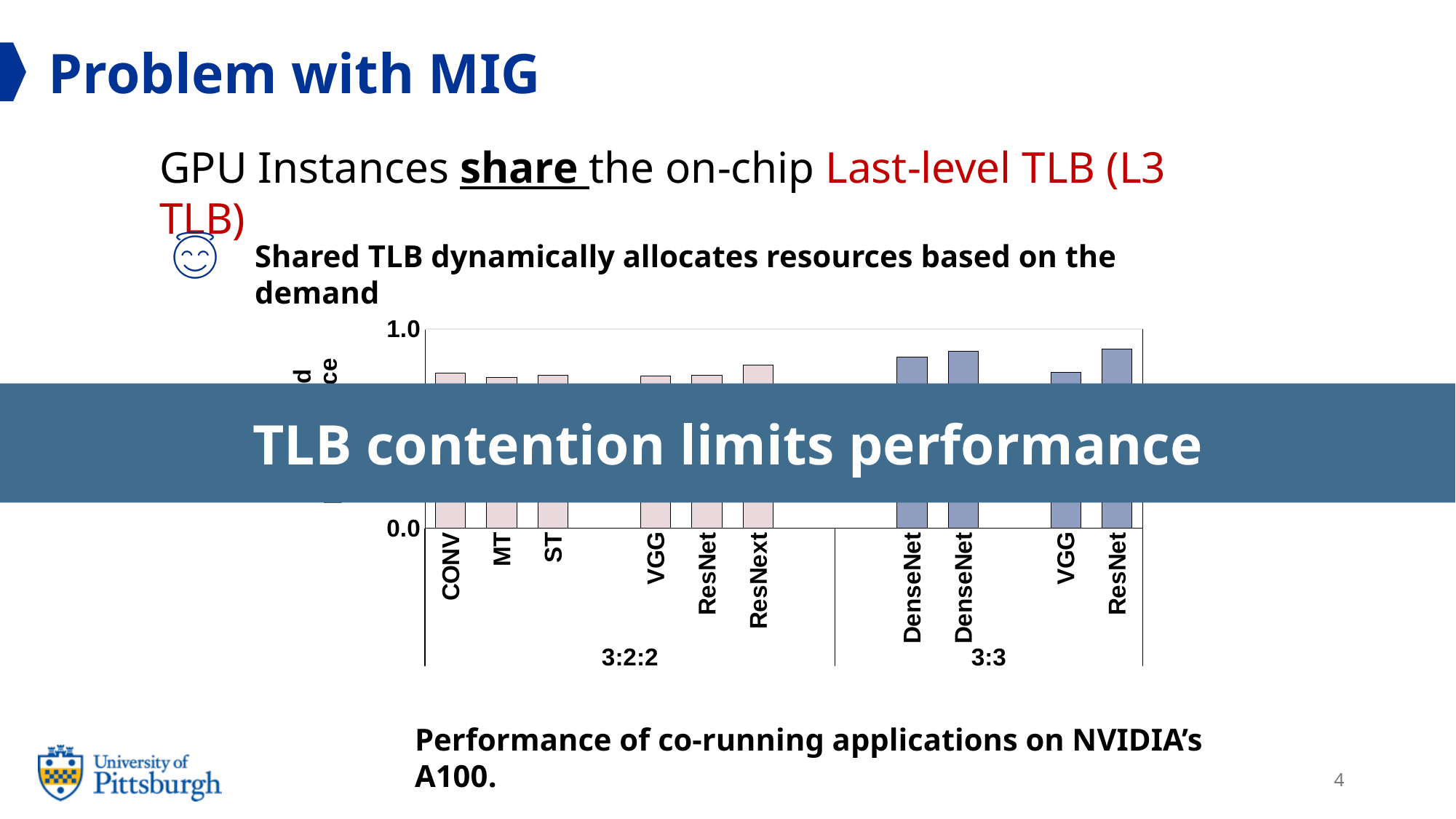
Which is larger, the value for ResNext in the 3:2:2 group or the value for ST in the 3:2:2 group? ResNext What kind of chart is shown on the slide? bar chart How many bars are in the 3:3 group of the chart? 4 Is the value for CONV in the 3:2:2 group greater or less than 1.0? less Which is larger, the value for DenseNet (first bar in the 3:3 group) or the value for MT in the 3:2:2 group? DenseNet What are the two group labels shown below the x axis of the chart? 3:2:2 and 3:3 Which is larger, the value for ResNet in the 3:3 group or the value for CONV in the 3:2:2 group? ResNet in the 3:3 group How many bars in the chart are labelled DenseNet? 2 How many bars are in the 3:2:2 group of the chart? 6 Is the value for ResNet in the 3:3 group greater or less than 1.0? less What is the highest tick value shown on the y axis of the chart? 1.0